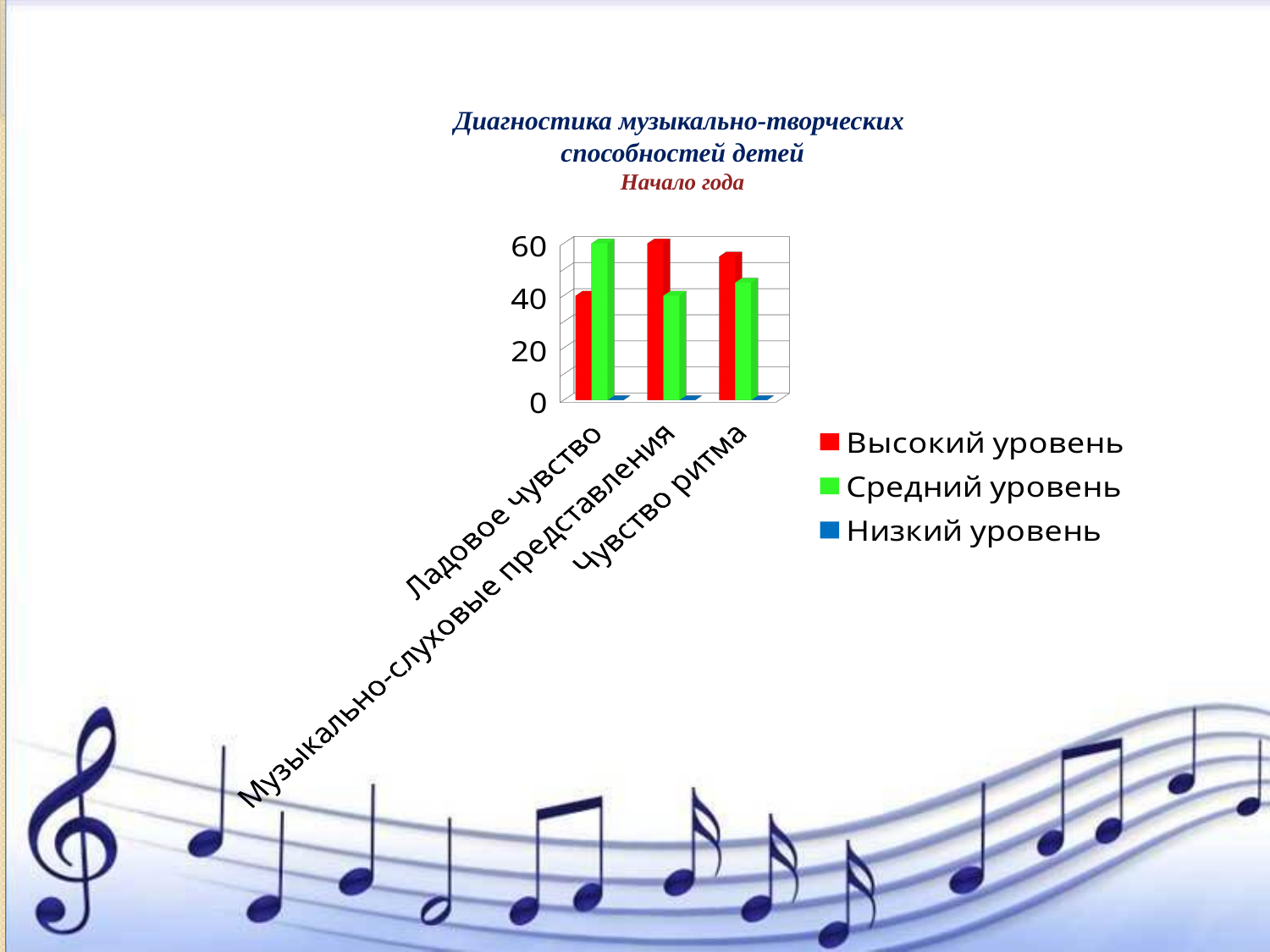
Is the value for Высокий уровень in the category Музыкально-слуховые представления greater or less than 40? greater Is the value for Средний уровень in the category Чувство ритма greater or less than 60? less Is the value for Средний уровень in the category Ладовое чувство greater or less than 40? greater Which series has the lowest values across all categories in the chart? Низкий уровень In the category Музыкально-слуховые представления, which is larger: Высокий уровень or Средний уровень? Высокий уровень What kind of chart is shown on the slide? bar chart How many series does the chart legend list? 3 In the category Ладовое чувство, which is larger: Высокий уровень or Средний уровень? Средний уровень How many categories are shown on the x axis of the chart? 3 What is the subtitle shown in red below the chart title? Начало года Which series is shown in red in the chart? Высокий уровень